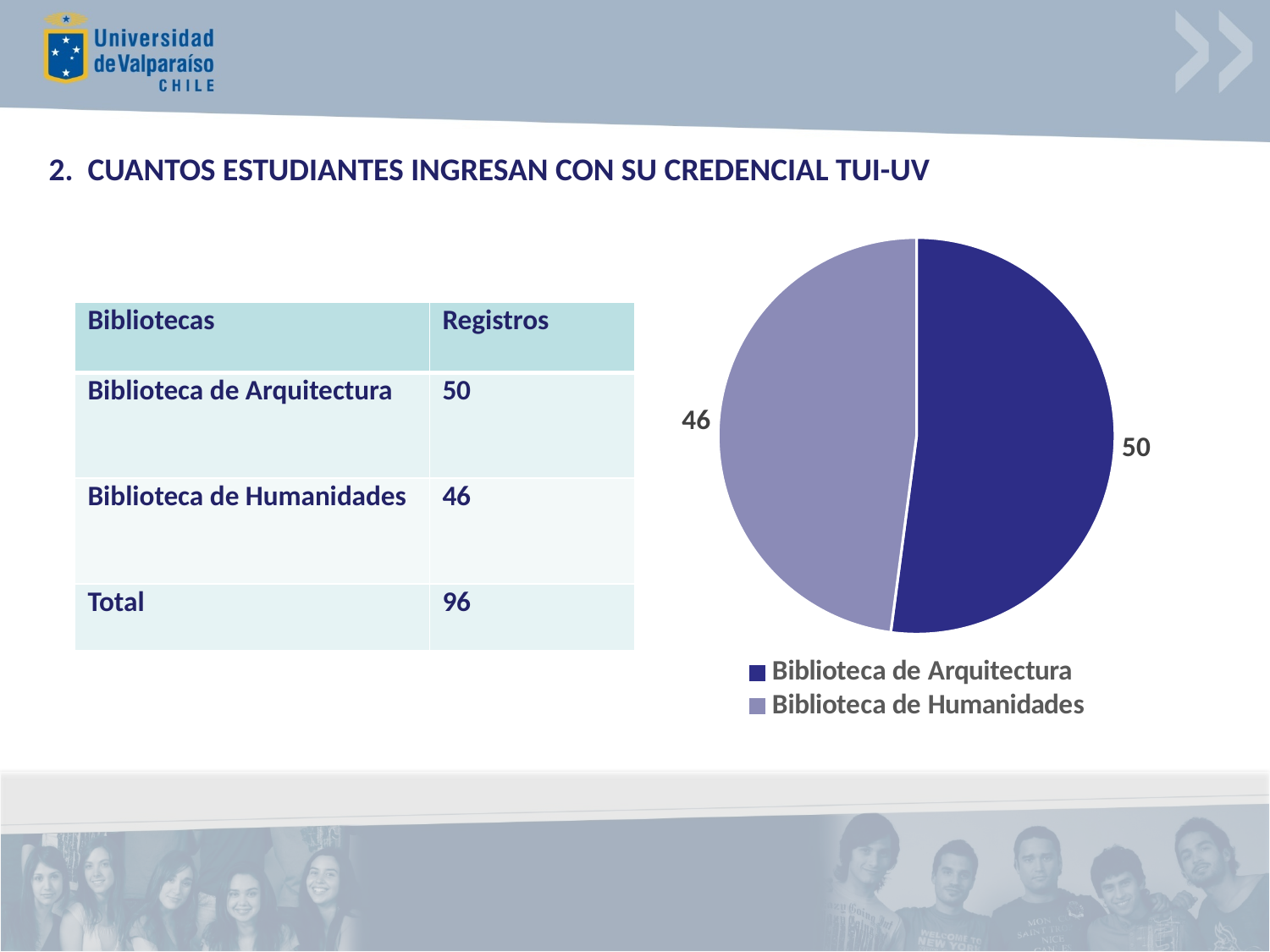
How many slices does the pie chart have? 2 Which is larger, the value for Biblioteca de Arquitectura or for Biblioteca de Humanidades? Biblioteca de Arquitectura What is the value for Biblioteca de Humanidades in the pie chart? 46 What is the total of the two values shown in the pie chart? 96 Which legend entry is shown in the darker blue colour? Biblioteca de Arquitectura Which slice of the pie chart is the smallest? Biblioteca de Humanidades What is the value for Biblioteca de Arquitectura in the pie chart? 50 What kind of chart is shown on the slide? pie chart How many entries does the legend of the pie chart list? 2 What is the difference between the values for Biblioteca de Arquitectura and Biblioteca de Humanidades? 4 Which slice of the pie chart is the largest? Biblioteca de Arquitectura